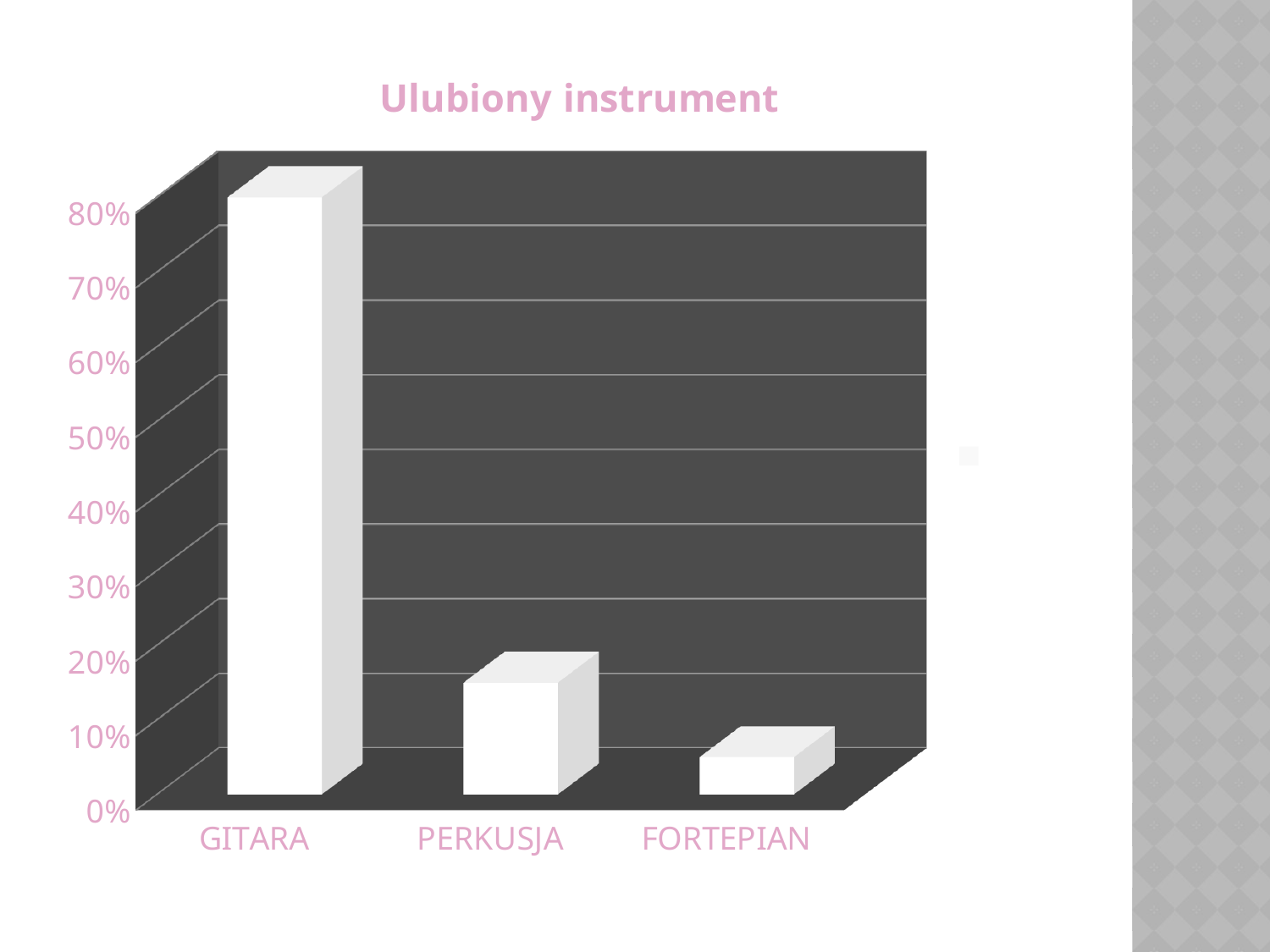
What kind of chart is shown on the slide? bar chart Which has a larger value, PERKUSJA or FORTEPIAN? PERKUSJA What is the highest value shown on the vertical axis of the chart? 80% Is the value for FORTEPIAN greater or less than 20%? less Which has a larger value, GITARA or PERKUSJA? GITARA What is the title of the chart? Ulubiony instrument Do the values rise or fall from left to right across the categories? fall Which category has the lowest value in the chart? FORTEPIAN Is the value for PERKUSJA greater or less than 30%? less Which category has the highest value in the chart? GITARA Is the value for GITARA greater or less than 50%? greater How many categories are shown on the x axis of the chart? 3